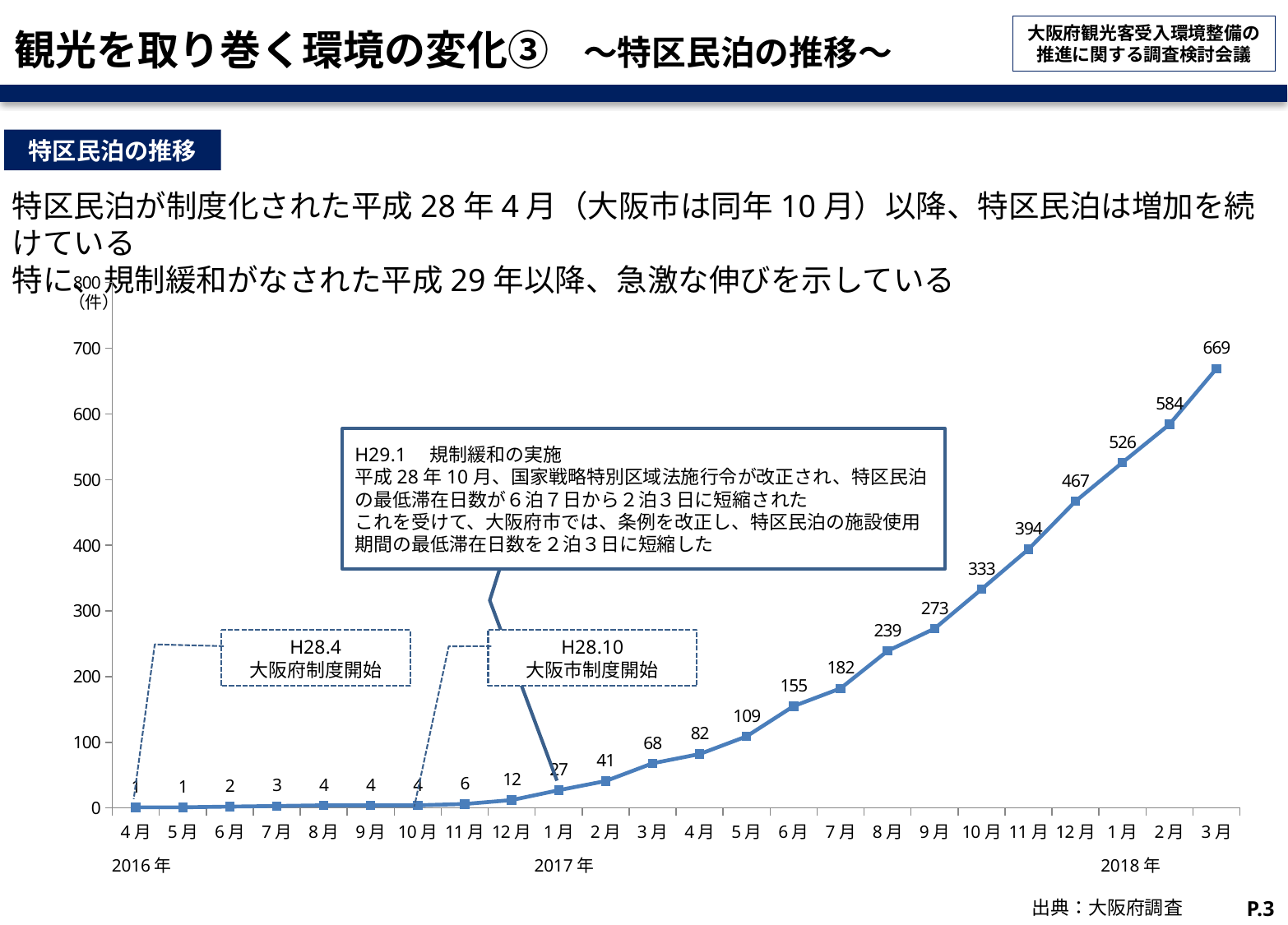
2018年3月と2018年2月の件数の差はいくつですか？ 85 グラフ上で件数が最も多い月はどれですか？ 2018年3月 2017年6月の特区民泊の件数はいくつですか？ 155 2017年8月と2017年7月では、どちらの件数が多いですか？ 2017年8月 このグラフの種類は何ですか？ 折れ線グラフ 2017年10月と2017年9月の件数の差はいくつですか？ 60 グラフには何か月分のデータ点がありますか？ 24 2017年11月の件数は300より多いですか、少ないですか？ 多い 縦軸の単位は何ですか？ 件 2018年3月の特区民泊の件数はいくつですか？ 669 2016年12月の特区民泊の件数はいくつですか？ 12 2016年4月から2018年3月にかけて、件数は増加していますか、減少していますか？ 増加